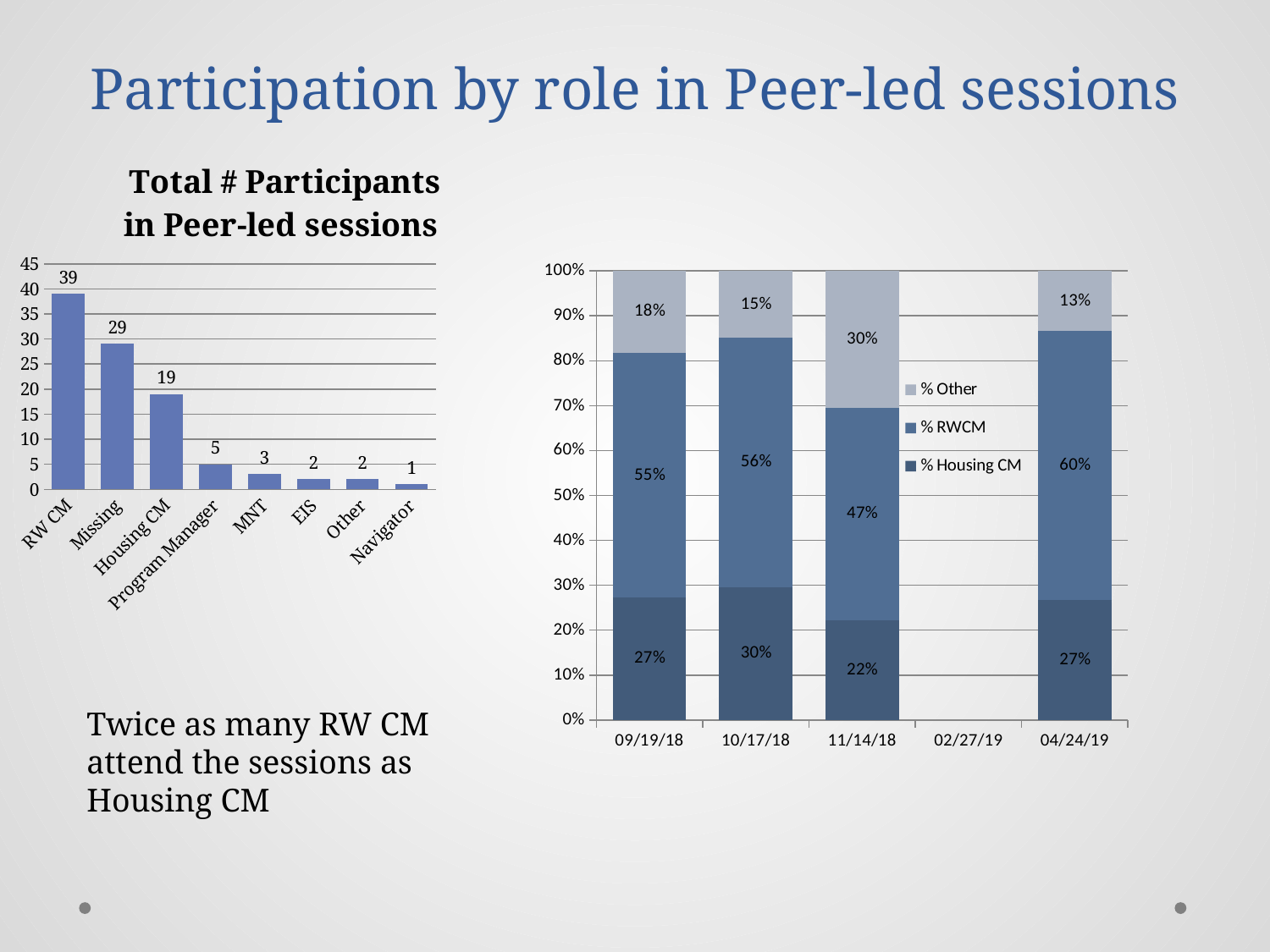
In the 'Total # Participants in Peer-led sessions' chart, how many participants are shown for Housing CM? 19 In the stacked bar chart on the right, which date has the lowest % Other value? 04/24/19 In the 'Total # Participants in Peer-led sessions' chart, which category has the lowest value? Navigator In the 'Total # Participants in Peer-led sessions' chart, how many participants are shown for RW CM? 39 In the stacked bar chart on the right, what is the % Other value for 11/14/18? 30% In the stacked bar chart on the right, what is the % RWCM value for 04/24/19? 60% What kind of chart is the 'Total # Participants in Peer-led sessions' chart? Bar chart In the 'Total # Participants in Peer-led sessions' chart, how many categories are shown on the x axis? 8 In the 'Total # Participants in Peer-led sessions' chart, what is the difference between the values for RW CM and Missing? 10 In the 'Total # Participants in Peer-led sessions' chart, which category has the highest value? RW CM In the stacked bar chart on the right, which is larger: the % Housing CM value for 10/17/18 or for 11/14/18? 10/17/18 How many series does the legend of the stacked bar chart on the right list? 3